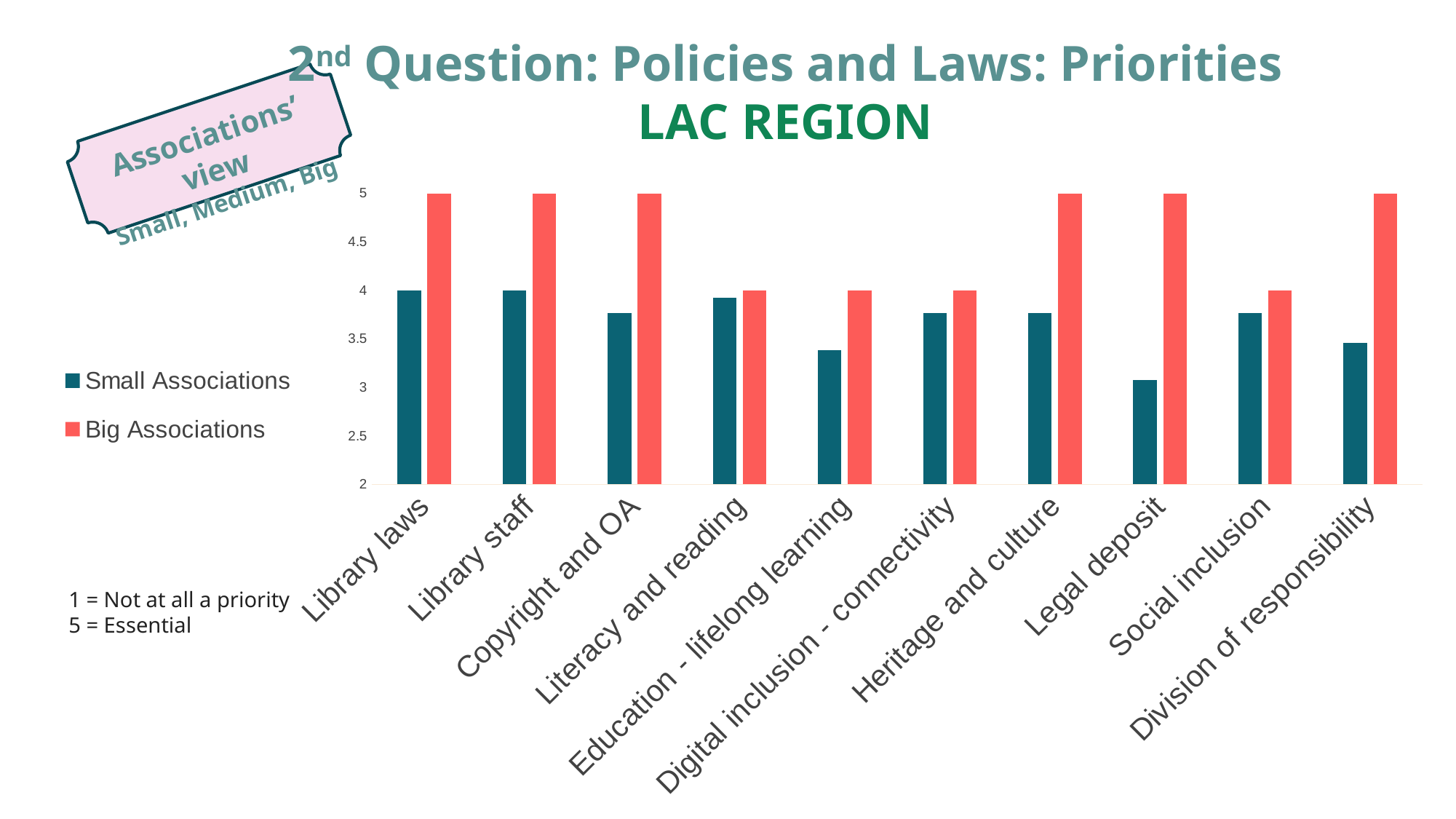
How many categories are shown on the x axis? 10 What is the value for Big Associations for Library laws? 5 Which category has the lowest value for Small Associations? Legal deposit Is the value for Small Associations for Education - lifelong learning greater or less than 3.5? less What is the value for Big Associations for Social inclusion? 4 What type of chart is shown on the slide? bar chart Which series is shown in red? Big Associations What is the value for Big Associations for Literacy and reading? 4 How many series does the legend list? 2 What is the value for Small Associations for Library staff? 4 Is the value for Small Associations for Copyright and OA greater or less than 3.5? greater For Legal deposit, which series has the larger value, Small Associations or Big Associations? Big Associations